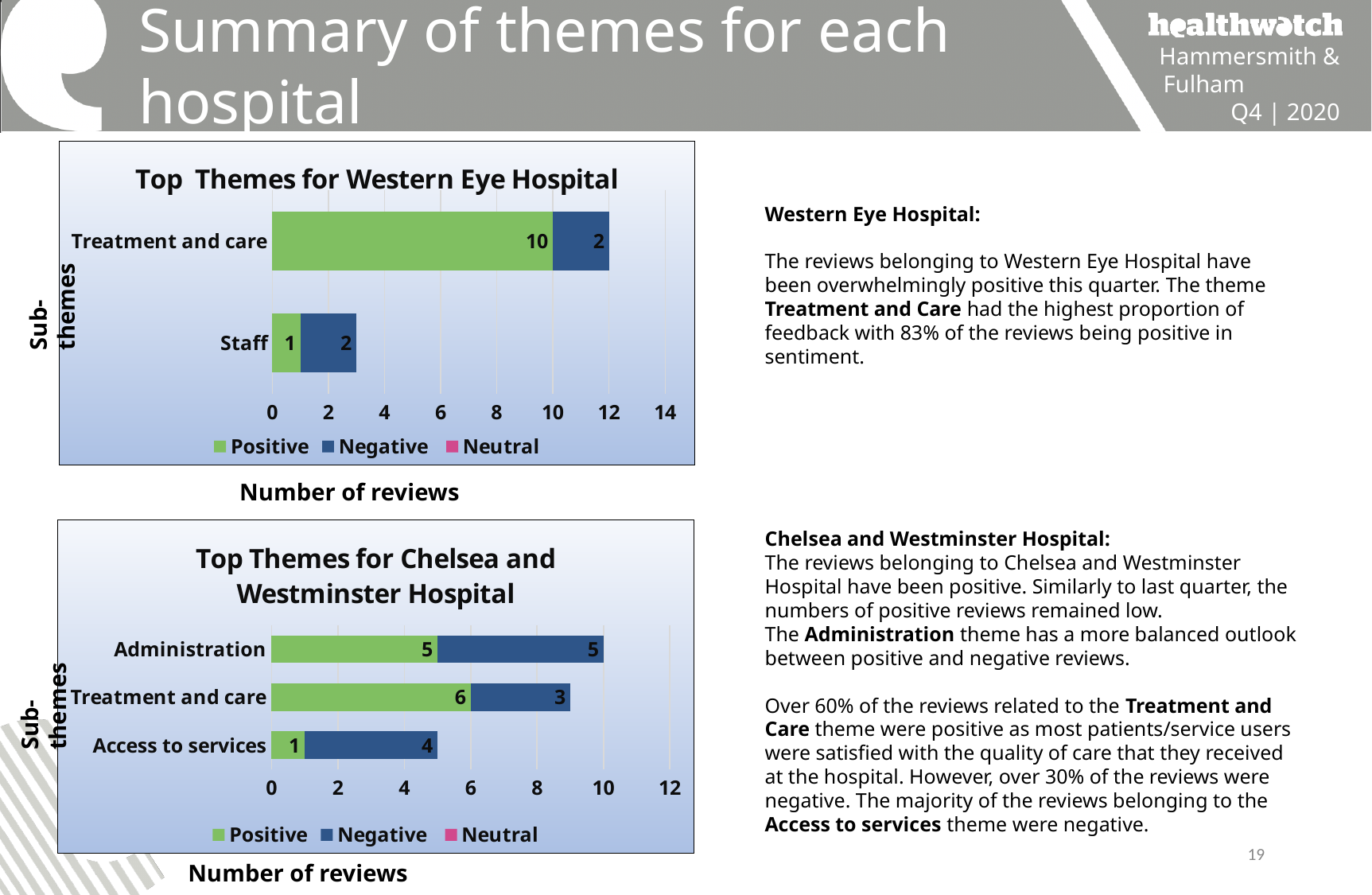
In the 'Top Themes for Western Eye Hospital' chart, how many Negative reviews are shown for Staff? 2 In the 'Top Themes for Western Eye Hospital' chart, what is the difference between the Positive and Negative reviews for Treatment and care? 8 In the 'Top Themes for Western Eye Hospital' chart, how many sub-themes are shown? 2 In the 'Top Themes for Western Eye Hospital' chart, how many series does the legend list? 3 In the 'Top Themes for Chelsea and Westminster Hospital' chart, how many Negative reviews are shown for Access to services? 4 In the 'Top Themes for Chelsea and Westminster Hospital' chart, which sub-theme has the highest number of Positive reviews? Treatment and care In the 'Top Themes for Western Eye Hospital' chart, how many Positive reviews are shown for Treatment and care? 10 In the 'Top Themes for Chelsea and Westminster Hospital' chart, how many Positive reviews are shown for Treatment and care? 6 In the 'Top Themes for Chelsea and Westminster Hospital' chart, which has more Negative reviews, Administration or Treatment and care? Administration In the 'Top Themes for Western Eye Hospital' chart, what is the total number of reviews for Treatment and care? 12 What type of chart is the 'Top Themes for Chelsea and Westminster Hospital' chart? Stacked bar chart In the 'Top Themes for Chelsea and Westminster Hospital' chart, what is the total number of reviews for Administration? 10